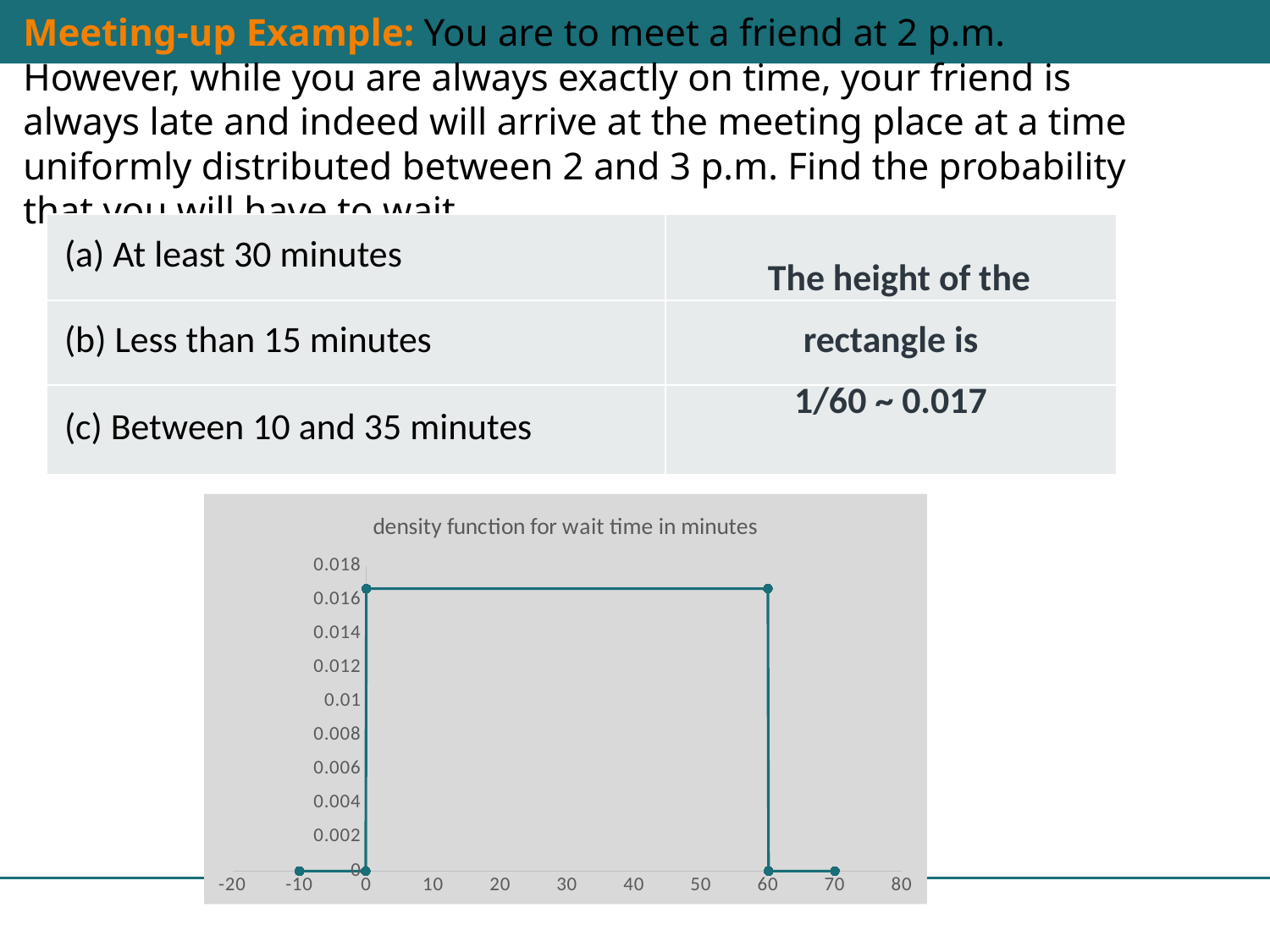
Is the density value at a wait time of 30 minutes greater or less than 0.014? greater Is the density value at a wait time of 30 minutes greater or less than 0.018? less How many data point markers are plotted on the chart? 6 Which is larger, the density at a wait time of 30 minutes or at 70 minutes? 30 minutes What is the density value plotted at a wait time of 70 minutes? 0 What kind of chart is shown on the slide? line chart Does the density rise, fall, or stay flat between wait times of 0 and 60 minutes? stay flat What is the density value plotted at a wait time of -10 minutes? 0 What is the title of the chart? density function for wait time in minutes What is the highest tick value shown on the vertical axis? 0.018 Over which range of wait times is the density at its highest level? 0 to 60 minutes